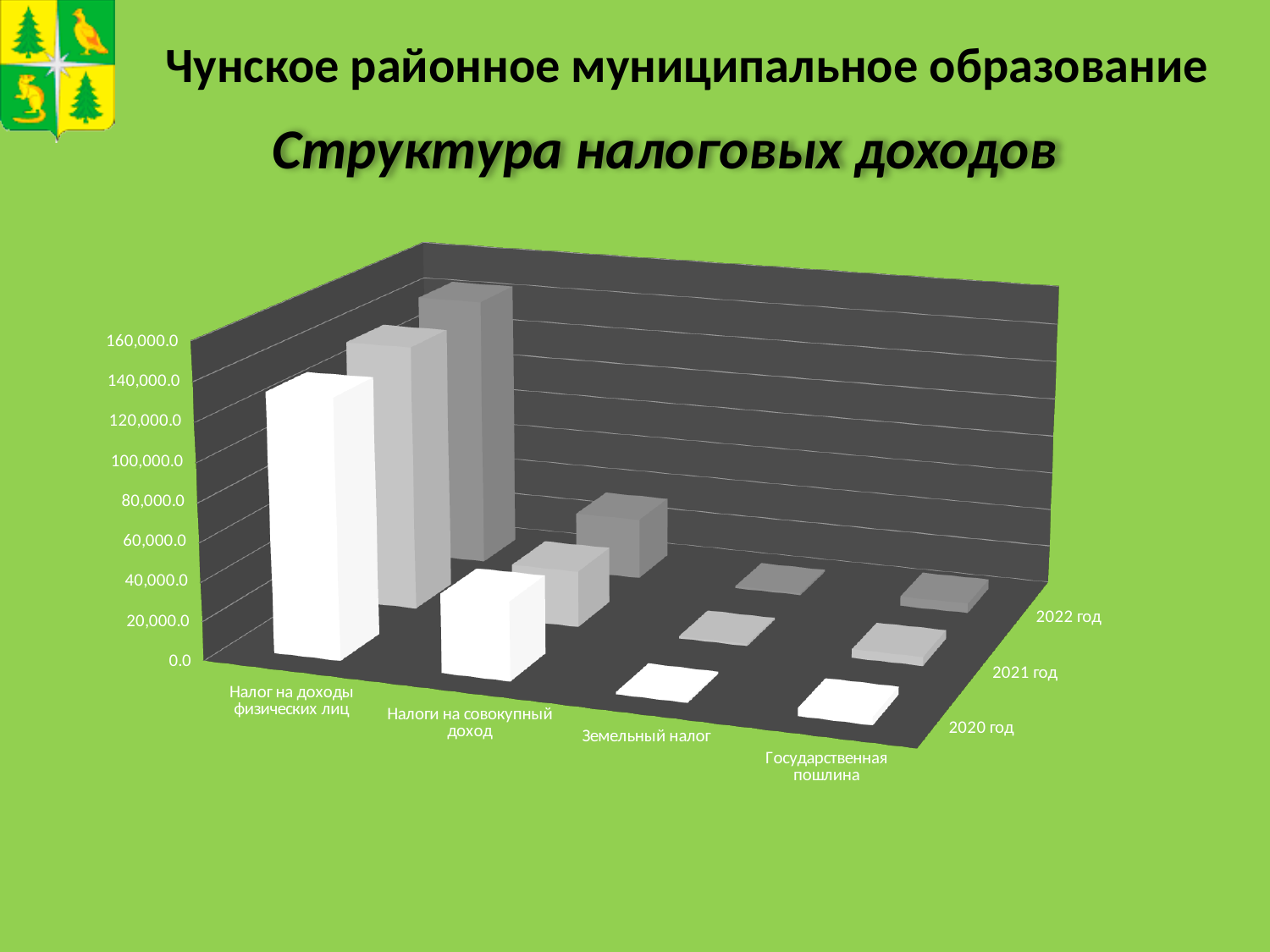
Which tax category has the highest values in the chart? Налог на доходы физических лиц Which years are shown as series in the chart? 2020 год, 2021 год, 2022 год How many tax categories are shown along the x axis of the chart? 4 What kind of chart is shown on the slide? bar chart How many years (series) does the chart show? 3 What is the title of the chart? Структура налоговых доходов Which is larger in 2022 год: Налоги на совокупный доход or Земельный налог? Налоги на совокупный доход Which is larger in 2020 год: Налог на доходы физических лиц or Налоги на совокупный доход? Налог на доходы физических лиц Do the values for Налог на доходы физических лиц rise or fall from 2020 год to 2022 год? rise Is the value for Налог на доходы физических лиц in 2020 год greater or less than 80,000.0? greater Is the value for Государственная пошлина in 2022 год greater or less than 40,000.0? less Is the value for Земельный налог in 2020 год greater or less than 20,000.0? less